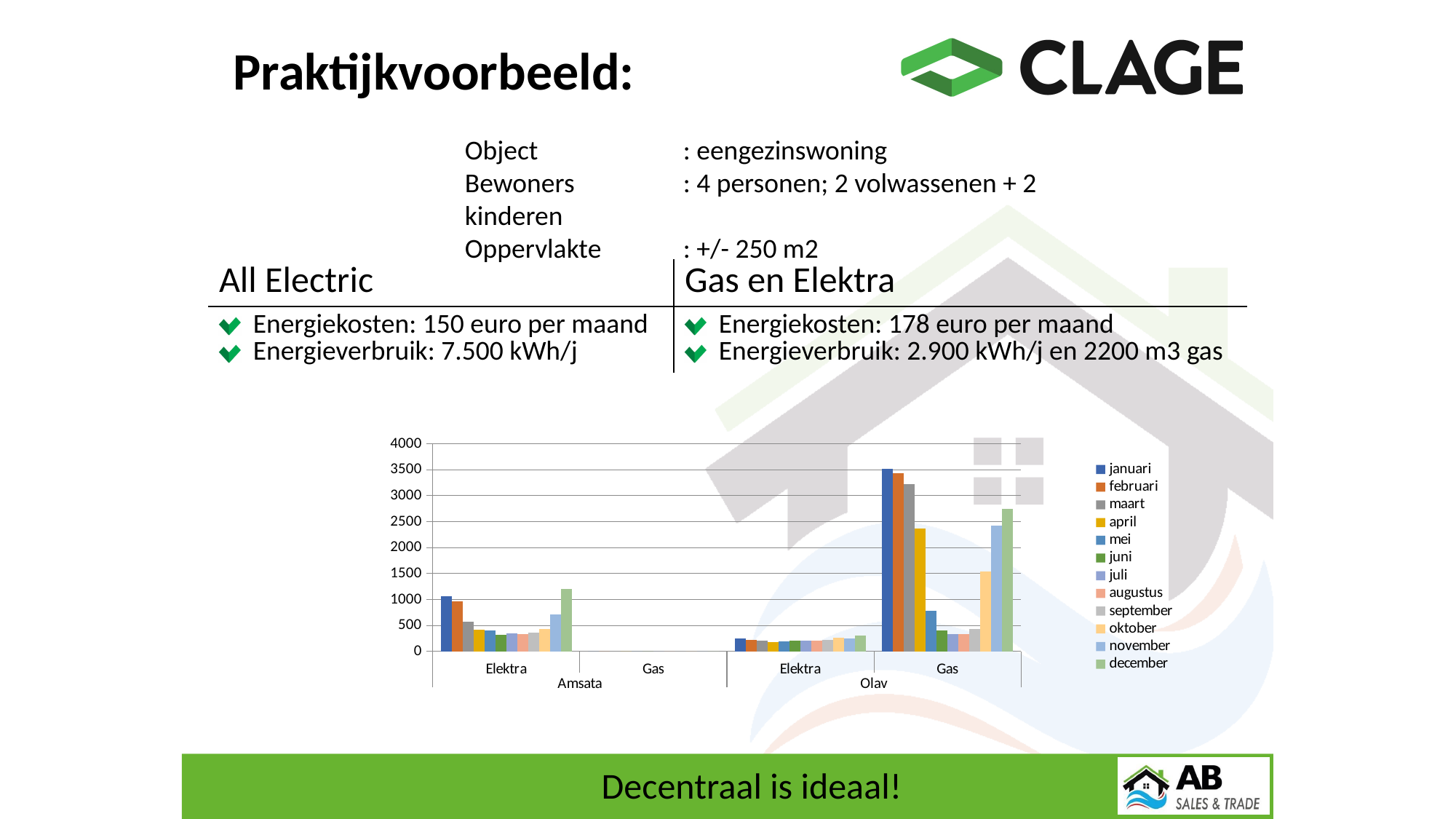
Which is the last series listed in the chart legend? december Is the value for december in the Amsata Elektra group greater or less than 1000? greater How many category groups are shown along the x axis of the chart? 4 How many series does the chart legend list? 12 Which category group has the tallest bars in the chart? Olav Gas Which category group shows no visible bars in the chart? Amsata Gas Is the value for januari in the Olav Gas group greater or less than 3000? greater What kind of chart is shown on the slide? bar chart Which is larger: the januari value in the Olav Gas group or the januari value in the Amsata Elektra group? Olav Gas Is the value for december in the Olav Gas group greater or less than 2500? greater Which is the first series listed in the chart legend? januari